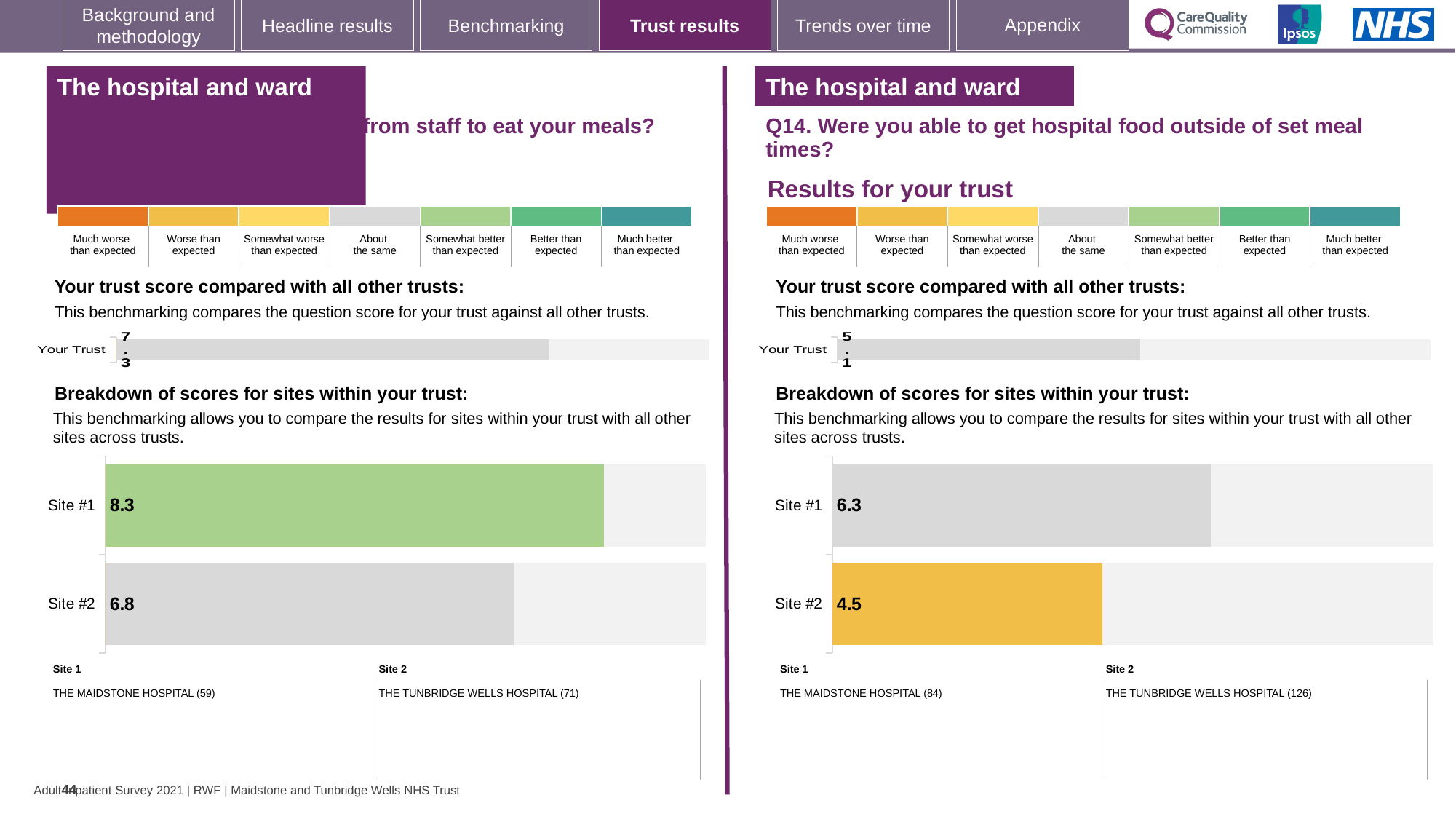
On the left-hand chart (breakdown of scores for sites), what is the difference between the Site #1 and Site #2 scores? 1.5 On the left-hand chart (breakdown of scores for sites), which site has the lower score? Site #2 On the right-hand chart for Q14, which site has the higher score? Site #1 On the right-hand chart for Q14, what is the score for Site #2? 4.5 On the left-hand chart (breakdown of scores for sites), what is the score for Site #2? 6.8 How many sites are shown in the right-hand breakdown chart for Q14? 2 What type of chart is used for the breakdown of scores for sites on the right-hand side? Bar chart On the left-hand chart (breakdown of scores for sites), what is the score for Site #1? 8.3 On the right-hand 'Your trust score compared with all other trusts' chart for Q14, what is the trust score? 5.1 On the left-hand 'Your trust score compared with all other trusts' chart, what is the trust score? 7.3 On the right-hand chart for Q14 (hospital food outside of set meal times), what is the score for Site #1? 6.3 On the right-hand chart for Q14, what is the difference between the Site #1 and Site #2 scores? 1.8